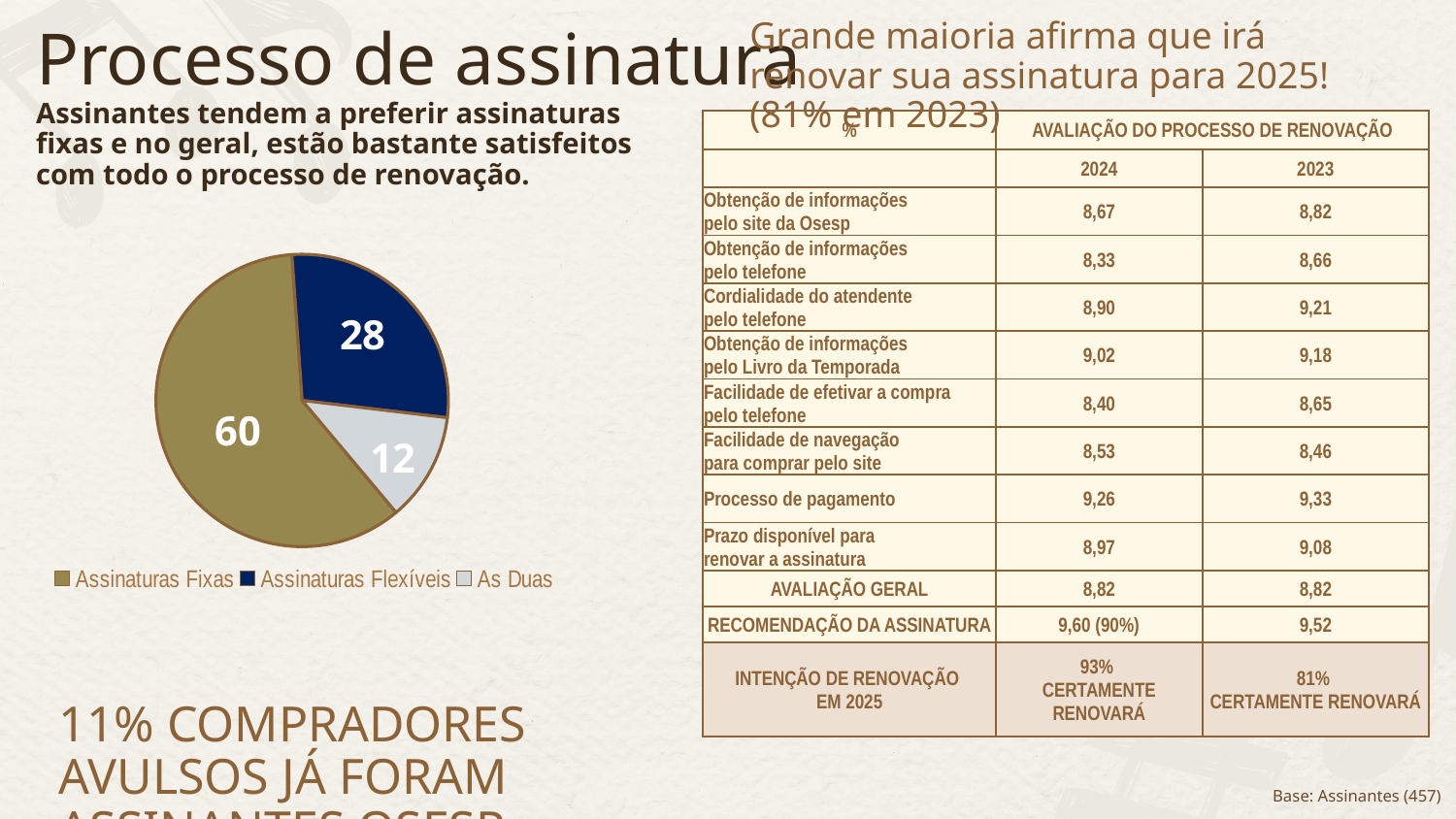
Which category has the smallest slice in the pie chart? As Duas What colour is the Assinaturas Flexíveis slice in the pie chart? dark blue What type of chart is shown on the left of the slide? pie chart In the pie chart, which is larger: Assinaturas Flexíveis or As Duas? Assinaturas Flexíveis What is the value for Assinaturas Fixas in the pie chart? 60 Which category has the largest slice in the pie chart? Assinaturas Fixas How many slices does the pie chart have? 3 What is the difference between the values for Assinaturas Flexíveis and As Duas in the pie chart? 16 What is the value for Assinaturas Flexíveis in the pie chart? 28 What is the difference between the values for Assinaturas Fixas and Assinaturas Flexíveis in the pie chart? 32 How many entries does the pie chart legend list? 3 What is the value for As Duas in the pie chart? 12